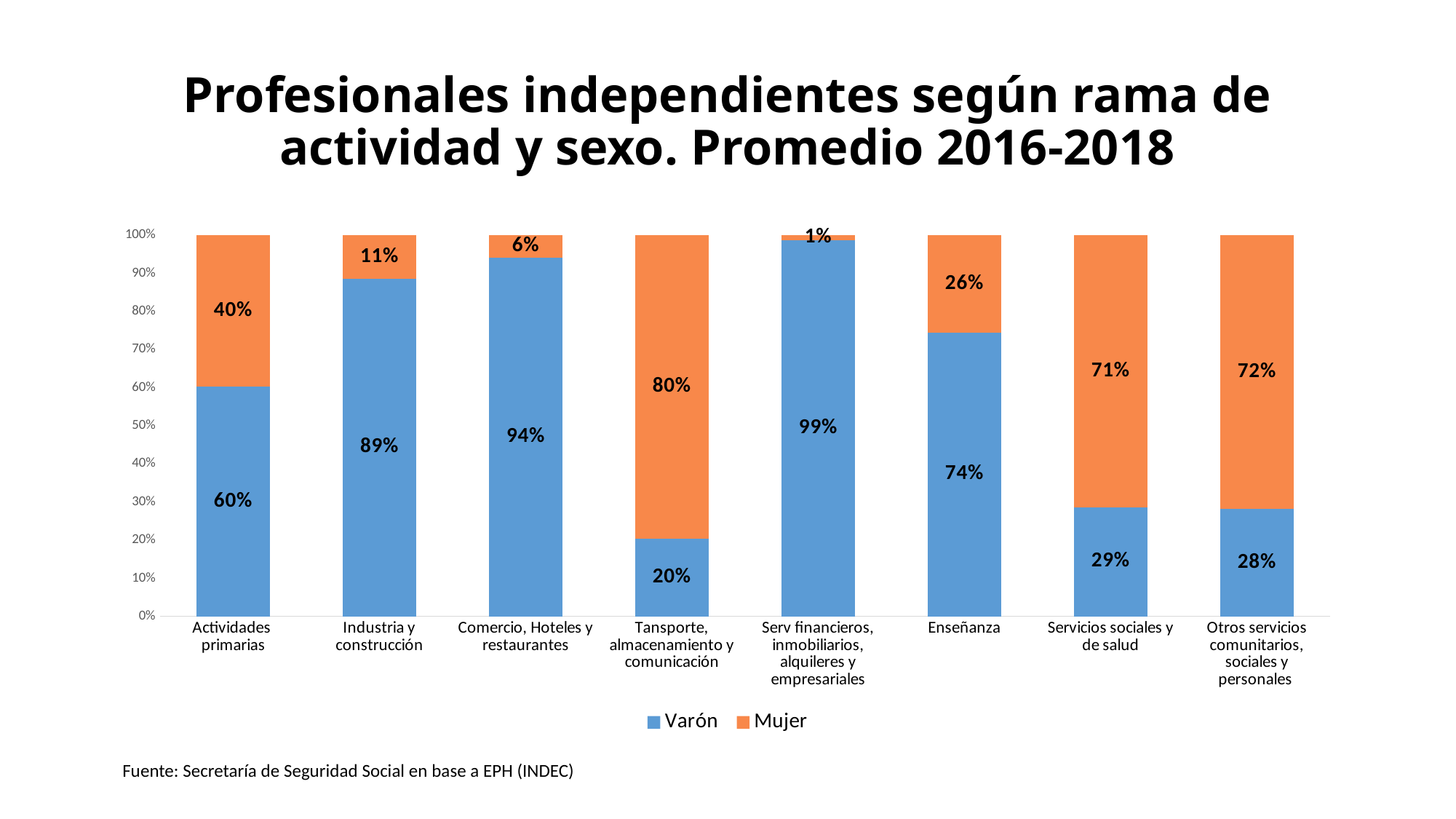
How many activity categories are shown on the x axis? 8 What is the Varón share for Enseñanza? 74% Which series is shown in orange? Mujer Is the Varón share for Actividades primarias greater or less than 50%? greater Which category has the highest Varón share? Serv financieros, inmobiliarios, alquileres y empresariales Which is larger: the Varón share for Industria y construcción or the Varón share for Comercio, Hoteles y restaurantes? Comercio, Hoteles y restaurantes What is the Mujer share for Tansporte, almacenamiento y comunicación? 80% Which category has the lowest Mujer share? Serv financieros, inmobiliarios, alquileres y empresariales What is the Varón share for Servicios sociales y de salud? 29% What kind of chart is shown on the slide? Stacked bar chart How many series does the legend list? 2 What is the difference between the Mujer share for Actividades primarias and the Mujer share for Enseñanza? 14%